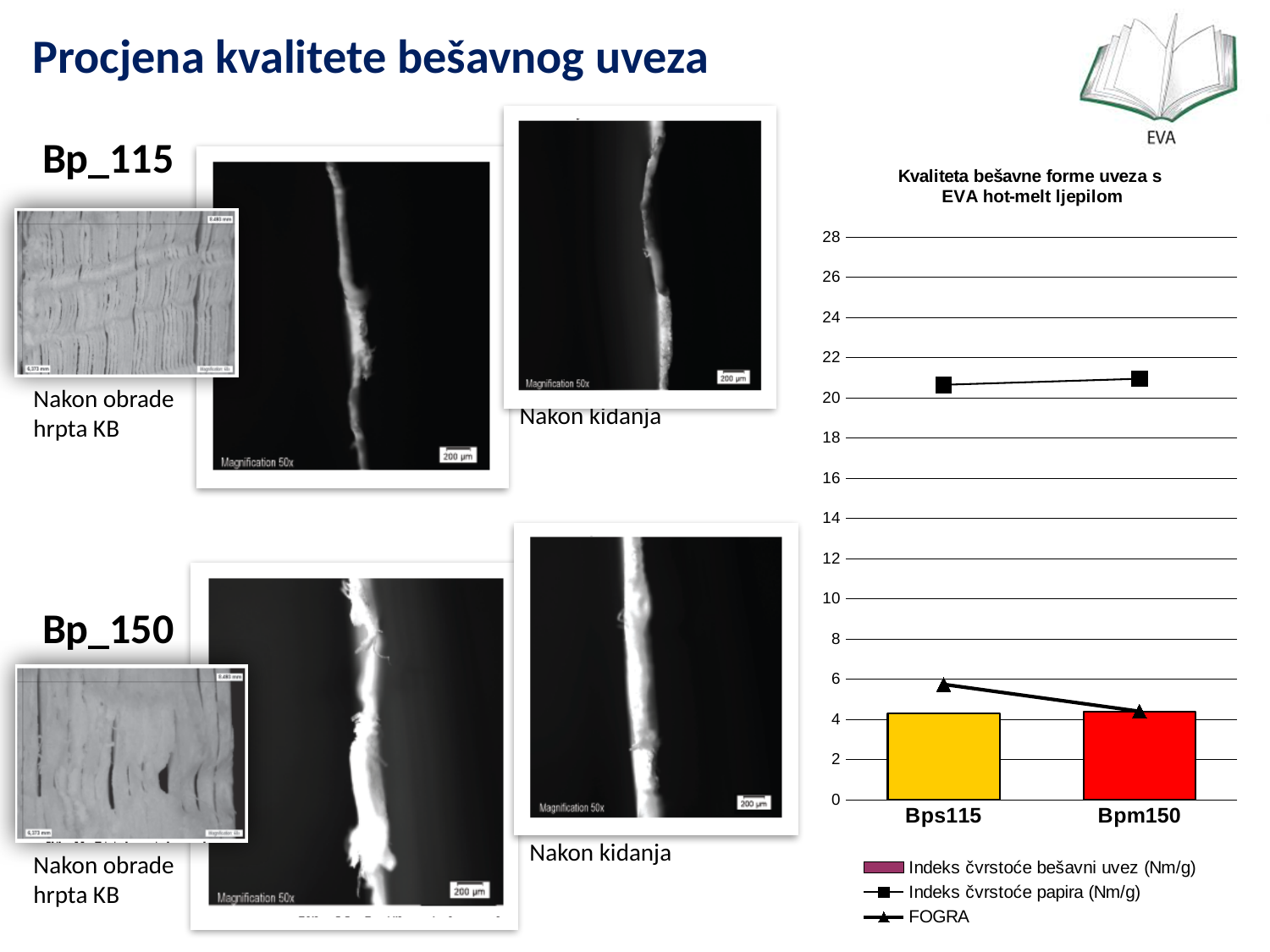
What kind of chart is shown on the right side of the slide? A bar chart combined with line series How many categories are shown on the x axis of the chart? 2 Which is larger for Bps115: the FOGRA value or the Indeks čvrstoće papira (Nm/g) value? Indeks čvrstoće papira (Nm/g) Which series in the chart is drawn with triangle markers? FOGRA Is the value of Indeks čvrstoće papira (Nm/g) for Bpm150 greater or less than 22? less How many series does the chart legend list? 3 What is the title of the chart on the slide? Kvaliteta bešavne forme uveza s EVA hot-melt ljepilom Does the FOGRA series rise or fall from Bps115 to Bpm150? fall Is the FOGRA value for Bpm150 greater or less than 6? less Is the value of Indeks čvrstoće bešavni uvez (Nm/g) for Bps115 greater or less than 6? less Which category has the higher FOGRA value, Bps115 or Bpm150? Bps115